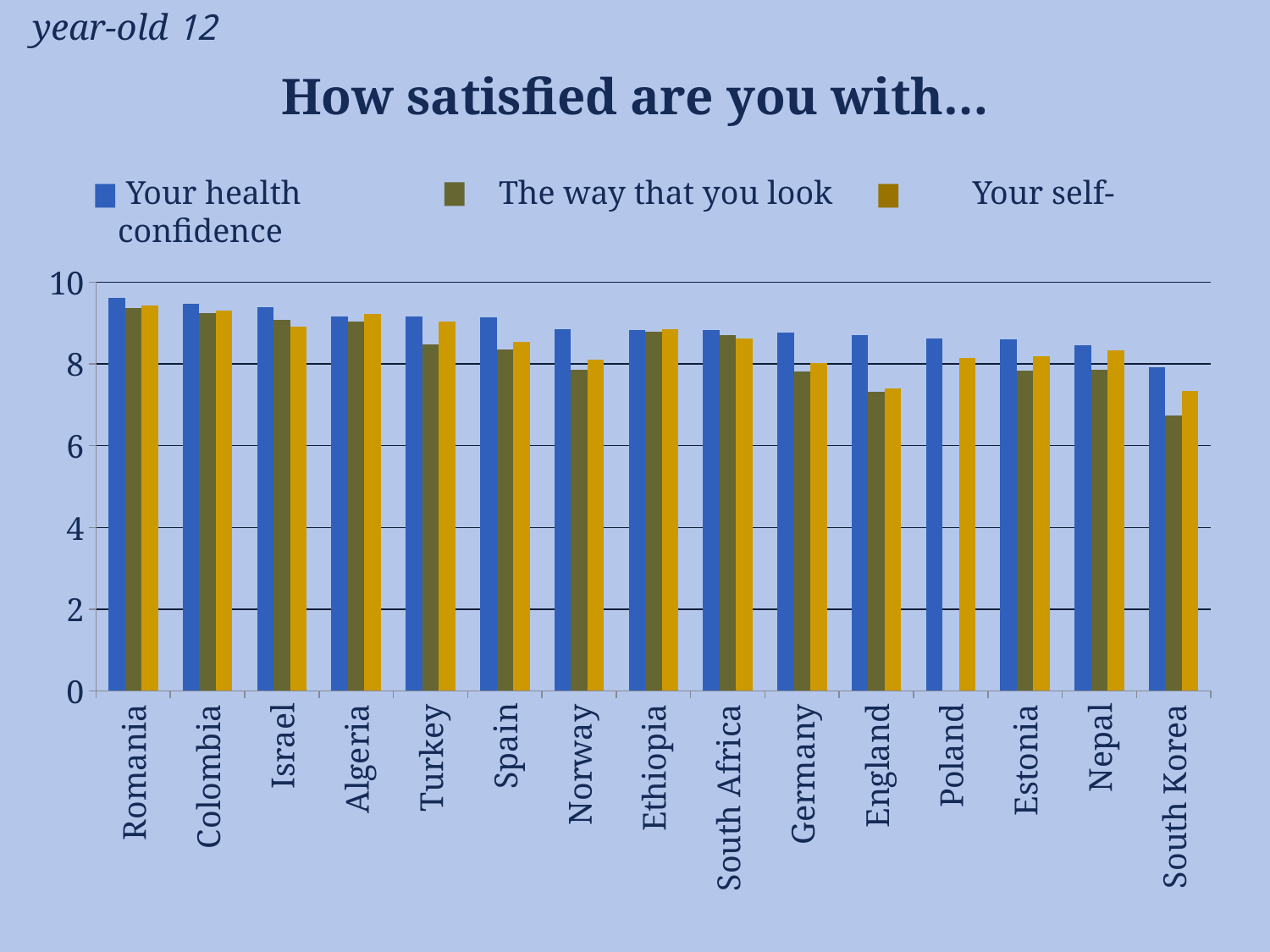
What is the title of the chart? How satisfied are you with... Which country has the lowest value for 'Your health'? South Korea Is the value for 'Your health' in Romania greater or less than 8? greater For Germany, which is larger: the value for 'Your health' or the value for 'The way that you look'? Your health What kind of chart is shown on the slide? bar chart Do the values for 'Your health' generally rise or fall from left to right across the countries? fall Which country has the lowest value for 'The way that you look'? South Korea How many countries are shown on the x axis of the chart? 15 For Turkey, which is larger: the value for 'Your health' or the value for 'The way that you look'? Your health Is the value for 'The way that you look' in South Korea greater or less than 8? less Is the value for 'The way that you look' in England greater or less than 8? less How many series does the chart's legend list? 3